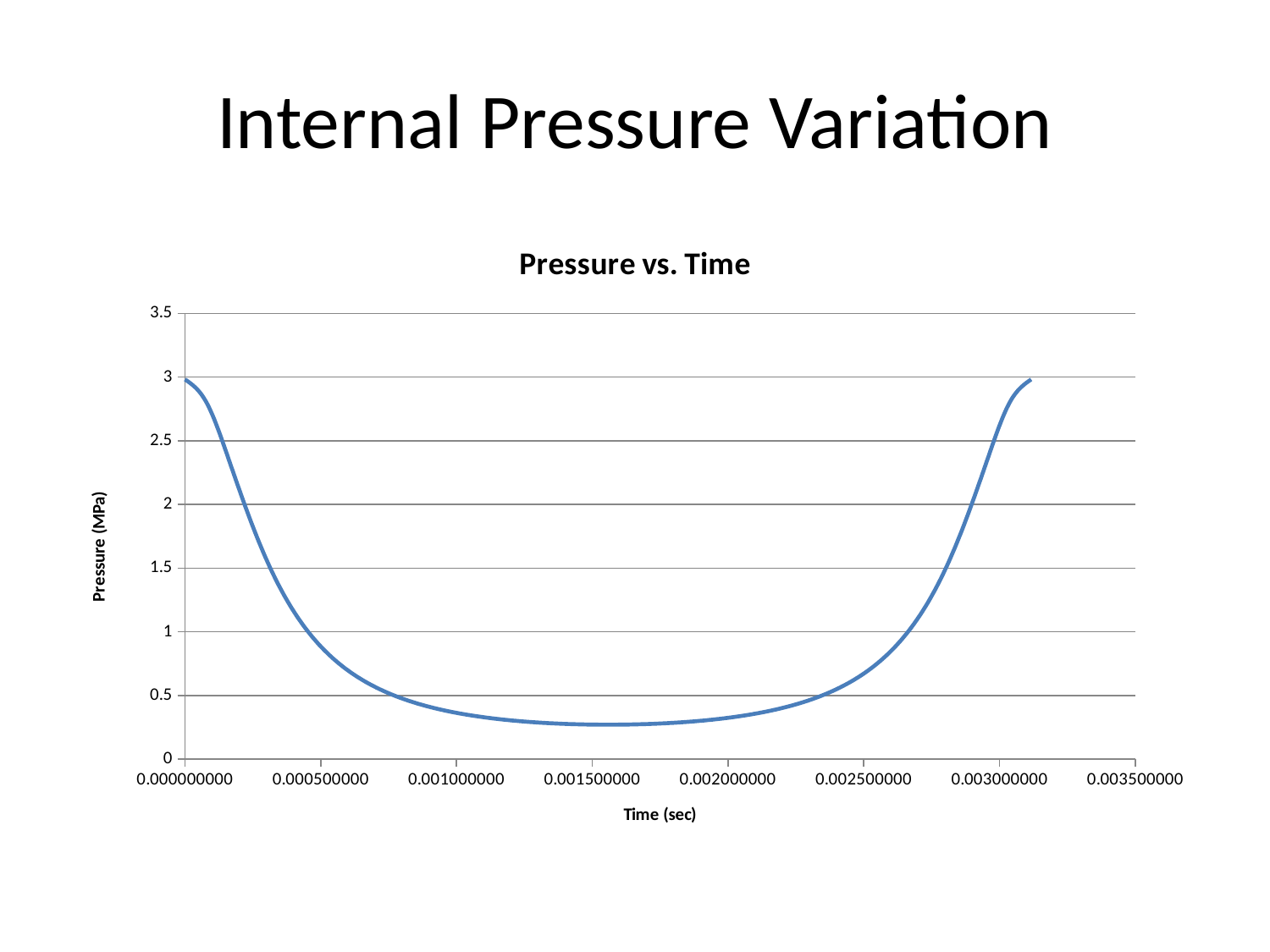
Does the pressure rise or fall between time 0.002000000 and time 0.003000000? rise Is the pressure at time 0.000500000 greater or less than 1? less Is the pressure at time 0.001000000 greater or less than 0.5? less Which is larger, the pressure at time 0.000500000 or the pressure at time 0.001500000? 0.000500000 What is the title of the chart? Pressure vs. Time Is the pressure at time 0.001500000 greater or less than 0.5? less What is the label of the vertical axis? Pressure (MPa) What kind of chart is shown on the slide? line chart Does the pressure rise or fall between time 0.000000000 and time 0.001000000? fall